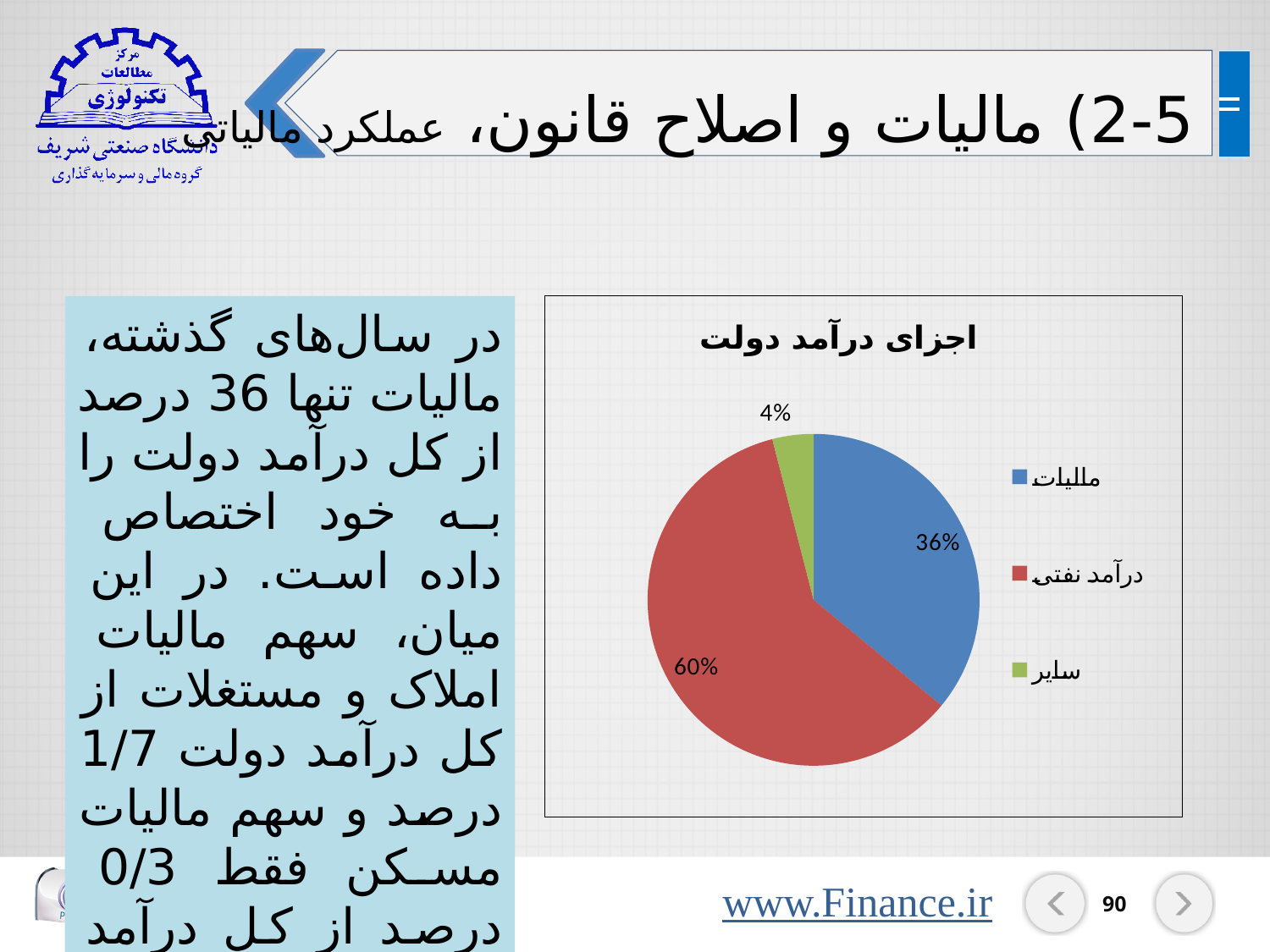
What share of the pie does سایر (other) represent? 4% What colour is the slice for درآمد نفتی? red What share of the pie does درآمد نفتی (oil revenue) represent? 60% Which is larger, the share for مالیات or the share for سایر? مالیات Which category has the largest slice of the pie? درآمد نفتی What is the combined share of مالیات and سایر? 40% What is the difference in percentage points between درآمد نفتی and مالیات? 24 What type of chart is shown on the slide? pie chart Which category has the smallest slice of the pie? سایر What share of the pie does مالیات (taxes) represent? 36% How many categories does the legend list? 3 What is the title of the chart? اجزای درآمد دولت